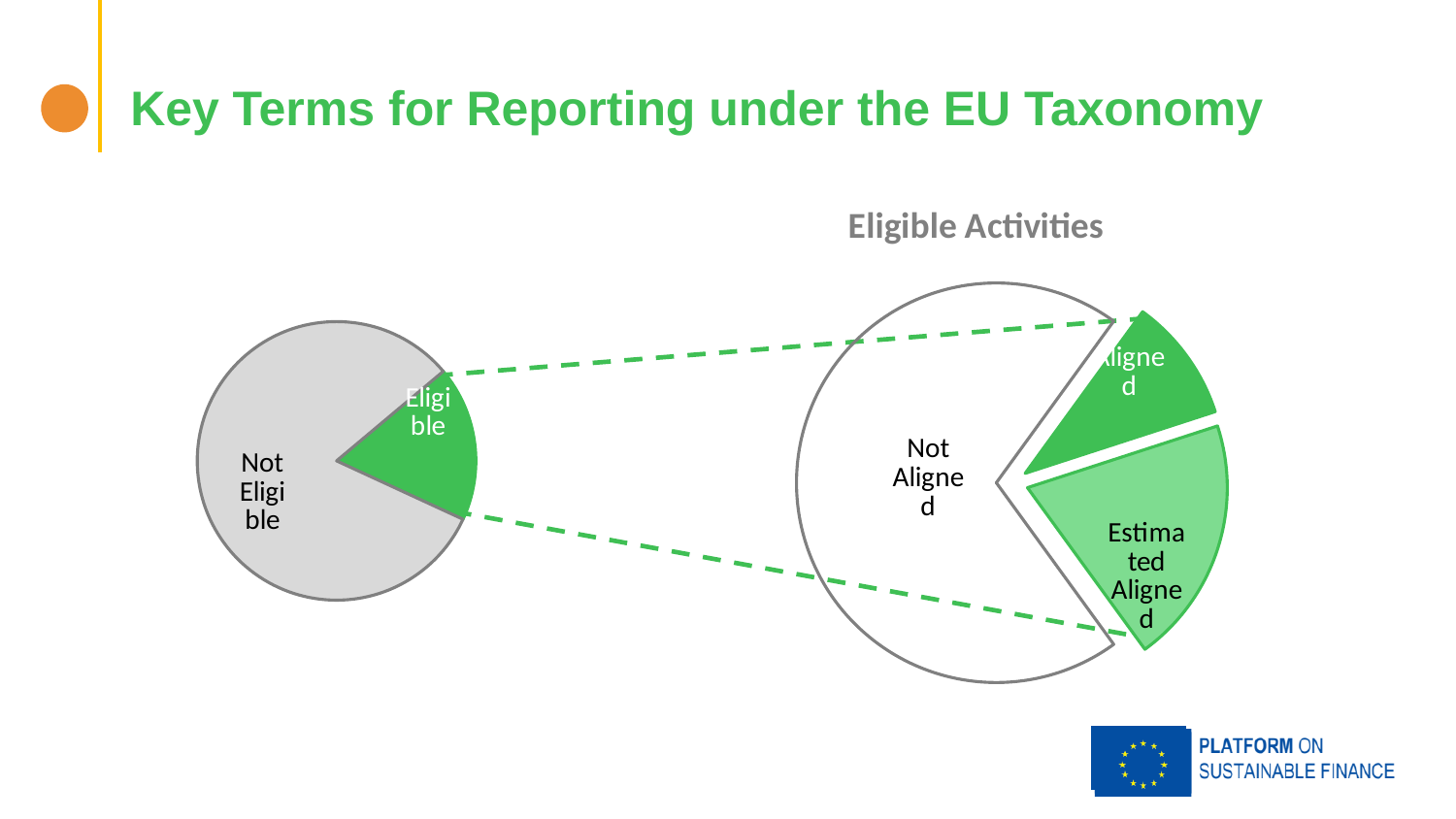
What is the title of the pie chart on the right of the slide? Eligible Activities In the pie chart on the left of the slide, what colour is the Not Eligible slice? grey In the pie chart on the left of the slide, which slice is the largest? Not Eligible In the pie chart on the left of the slide, which slice is larger: Eligible or Not Eligible? Not Eligible How many slices does the pie chart on the left of the slide have? 2 In the "Eligible Activities" pie chart, which slice is the smallest? Aligned What kind of chart is the chart on the left of the slide? pie chart How many slices does the "Eligible Activities" pie chart have? 3 In the "Eligible Activities" pie chart, which slice is the largest? Not Aligned In the pie chart on the left of the slide, which slice is the smallest? Eligible In the "Eligible Activities" pie chart, which slice is larger: Aligned or Estimated Aligned? Estimated Aligned What kind of chart is the chart titled "Eligible Activities"? pie chart